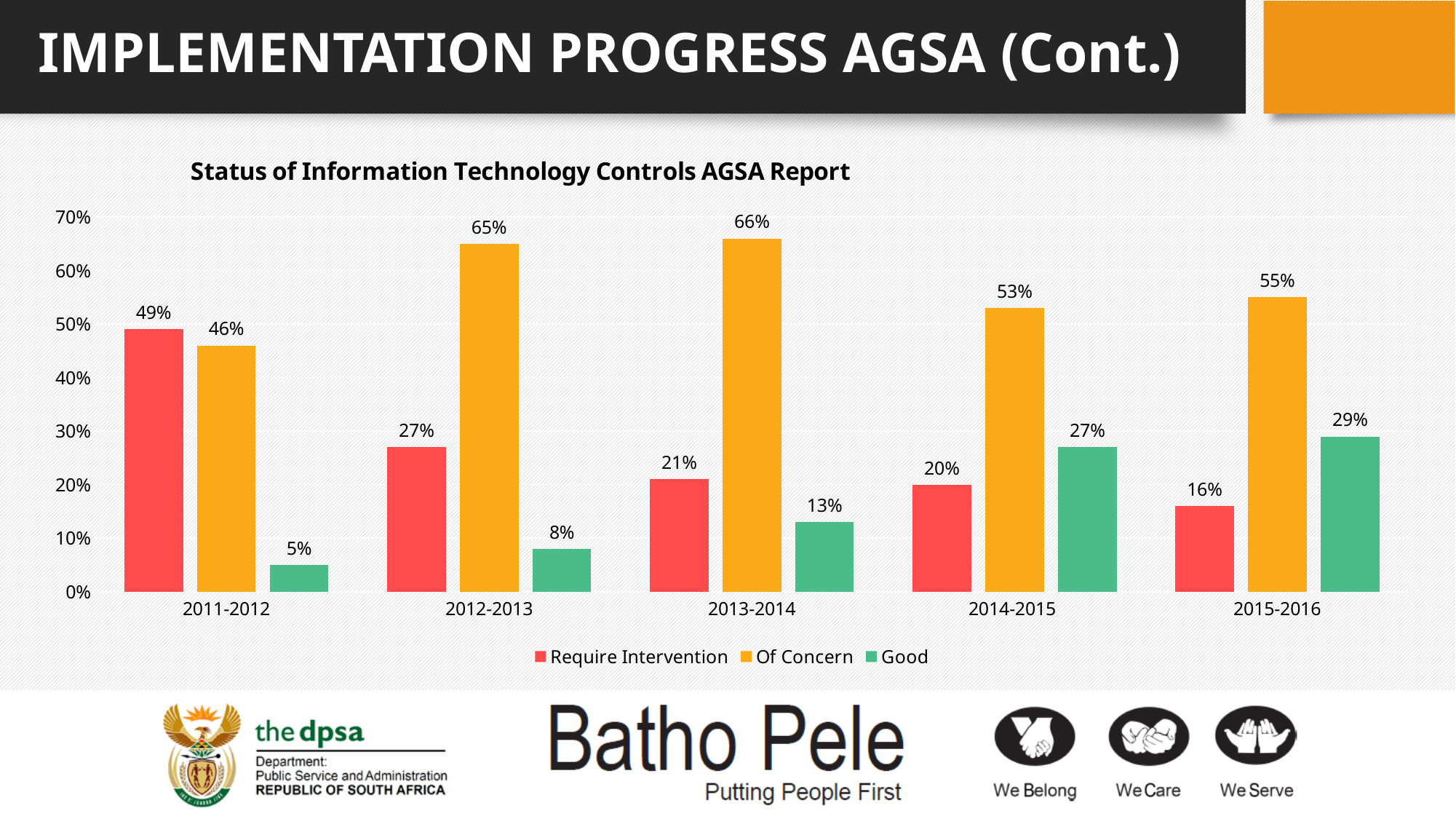
How many series does the legend list? 3 What is the value for Of Concern in 2013-2014? 66% In which year is the Good value lowest? 2011-2012 In which year is the Of Concern value highest? 2013-2014 What kind of chart is shown? Bar chart Which is larger in 2014-2015: Require Intervention or Good? Good What is the title of the chart? Status of Information Technology Controls AGSA Report What is the value for Require Intervention in 2011-2012? 49% What is the value for Good in 2015-2016? 29% How many year categories are shown on the x axis? 5 Does the Require Intervention value rise or fall from 2011-2012 to 2015-2016? Fall What is the difference between the Of Concern and Require Intervention values in 2012-2013? 38%